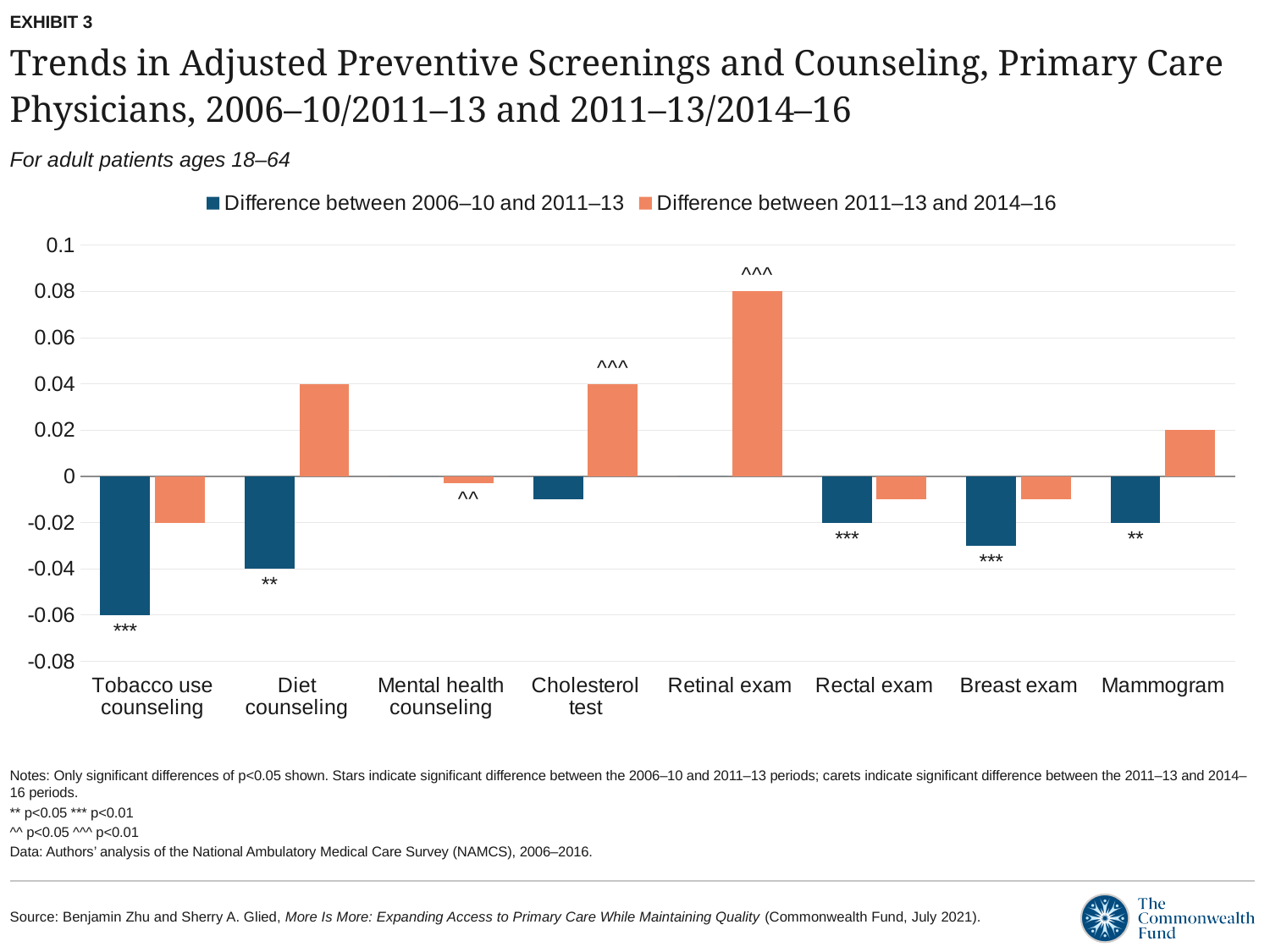
Which category has the highest value in the 'Difference between 2011–13 and 2014–16' series? Retinal exam In the 'Difference between 2011–13 and 2014–16' series, which is larger: Retinal exam or Cholesterol test? Retinal exam What is the value for Retinal exam in the 'Difference between 2011–13 and 2014–16' series? 0.08 What is the value for Mammogram in the 'Difference between 2006–10 and 2011–13' series? -0.02 What is the value for Tobacco use counseling in the 'Difference between 2006–10 and 2011–13' series? -0.06 What is the difference between the 'Difference between 2006–10 and 2011–13' values for Tobacco use counseling and Diet counseling? 0.02 How many series does the legend list? 2 How many categories are shown on the x axis? 8 What is the value for Diet counseling in the 'Difference between 2011–13 and 2014–16' series? 0.04 Which category has the lowest value in the 'Difference between 2006–10 and 2011–13' series? Tobacco use counseling Is the value for Breast exam in the 'Difference between 2006–10 and 2011–13' series greater or less than -0.02? less What kind of chart is shown on the slide? Bar chart